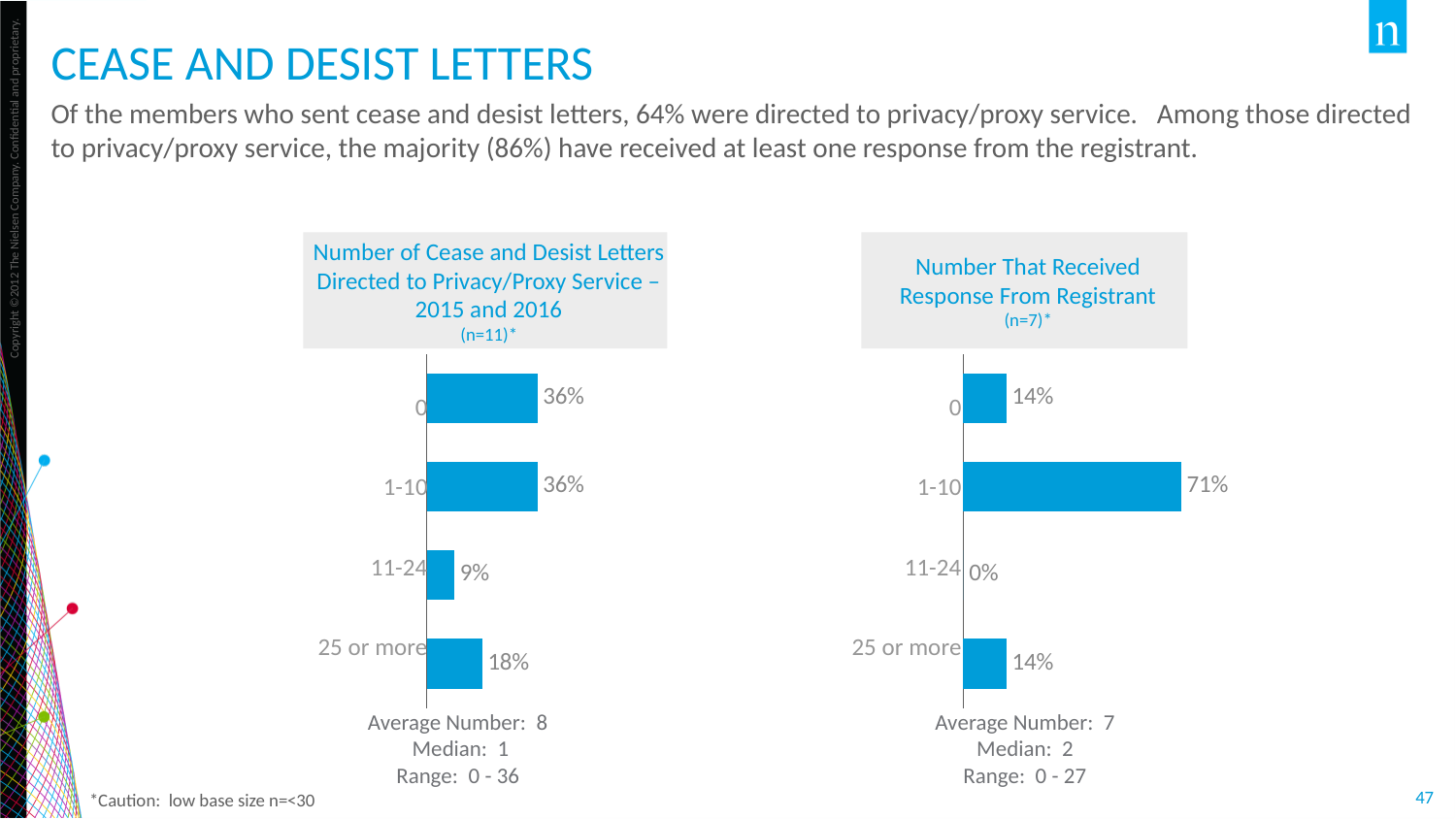
In the 'Number That Received Response From Registrant' chart, which category has the highest value? 1-10 In the 'Number That Received Response From Registrant' chart, what is the value for '11-24'? 0% In the 'Number That Received Response From Registrant' chart, what is the value for '1-10'? 71% In the 'Number of Cease and Desist Letters Directed to Privacy/Proxy Service' chart, which category has the lowest value? 11-24 How many categories are shown in the 'Number That Received Response From Registrant' chart? 4 In the 'Number That Received Response From Registrant' chart, which category has the lowest value? 11-24 In the 'Number of Cease and Desist Letters Directed to Privacy/Proxy Service' chart, what is the difference between the values for '25 or more' and '11-24'? 9% In the 'Number of Cease and Desist Letters Directed to Privacy/Proxy Service' chart, which is larger: the value for '25 or more' or the value for '11-24'? 25 or more What type of chart is the 'Number of Cease and Desist Letters Directed to Privacy/Proxy Service' chart? Bar chart In the 'Number of Cease and Desist Letters Directed to Privacy/Proxy Service' chart, what is the value for '11-24'? 9% In the 'Number That Received Response From Registrant' chart, what is the difference between the values for '1-10' and '0'? 57% In the 'Number of Cease and Desist Letters Directed to Privacy/Proxy Service' chart, what is the value for '25 or more'? 18%